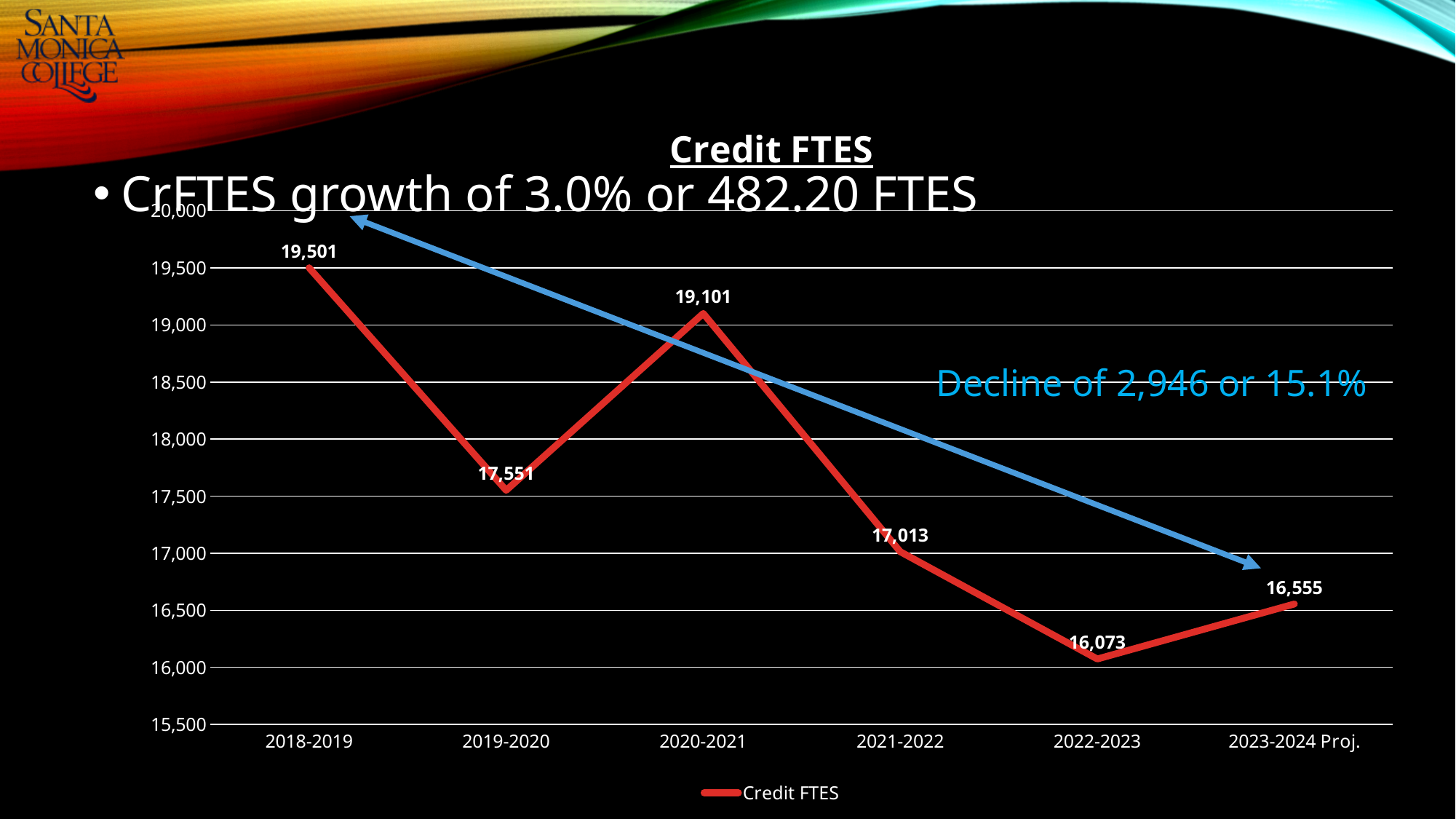
What is the difference in Credit FTES between 2020-2021 and 2021-2022? 2,088 How many years are plotted on the x axis? 6 Which is larger, the Credit FTES for 2019-2020 or for 2021-2022? 2019-2020 What is the title of the chart? Credit FTES Which year has the lowest Credit FTES value? 2022-2023 What is the Credit FTES value for 2018-2019? 19,501 What kind of chart is shown on the slide? Line chart Which year has the highest Credit FTES value? 2018-2019 How many series does the legend list? 1 What is the Credit FTES value for 2022-2023? 16,073 What is the projected Credit FTES value for 2023-2024? 16,555 What is the difference in Credit FTES between 2018-2019 and 2019-2020? 1,950